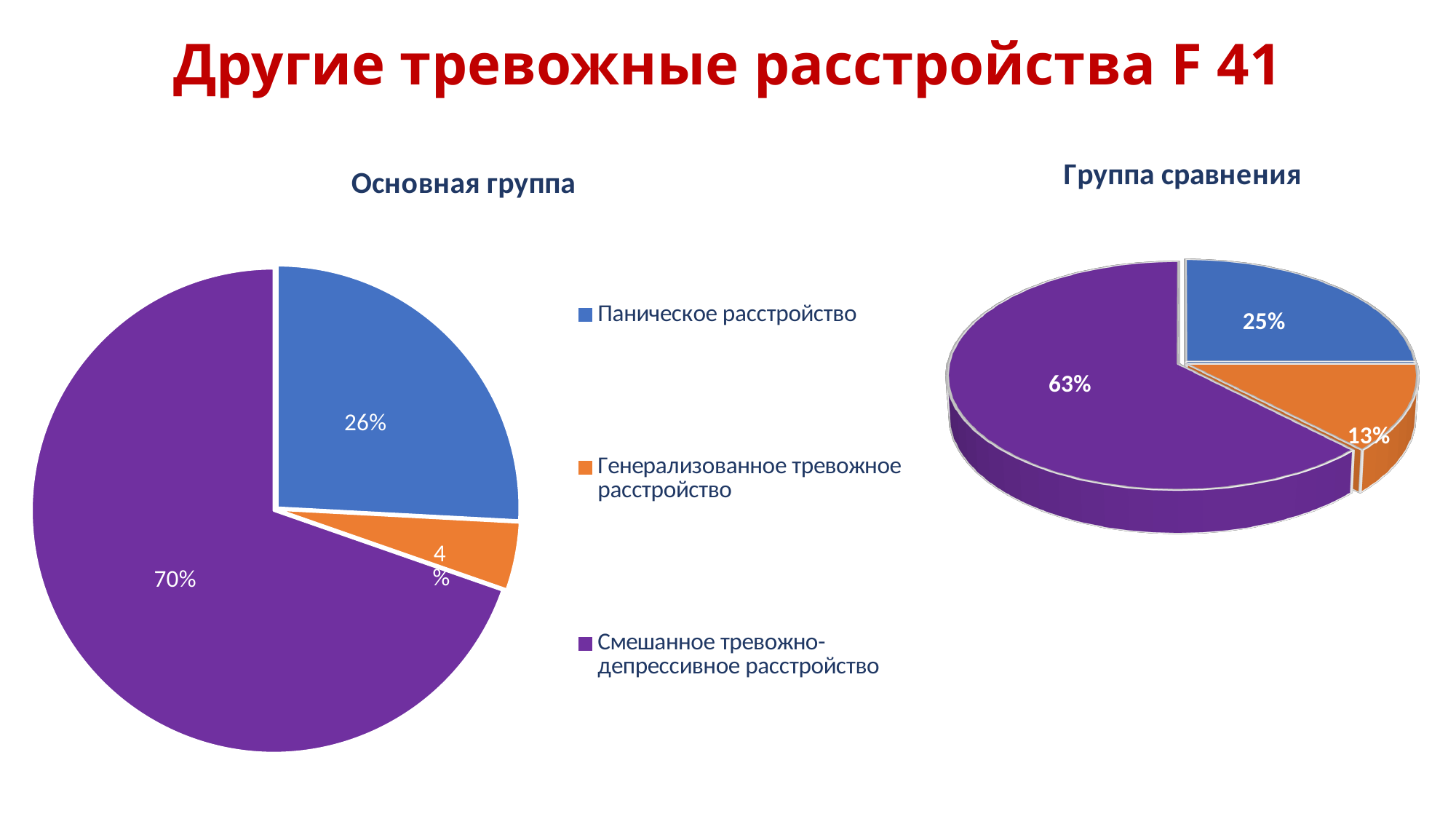
In the "Основная группа" chart, which category has the smallest slice? Генерализованное тревожное расстройство In the "Группа сравнения" chart, what share does "Паническое расстройство" have? 25% What kind of chart is the "Основная группа" chart? Pie chart What colour represents "Паническое расстройство" in the legend? Blue In the "Основная группа" chart, what share does "Паническое расстройство" have? 26% In the "Группа сравнения" chart, what share does "Генерализованное тревожное расстройство" have? 13% In the "Группа сравнения" chart, which category has the largest slice? Смешанное тревожно-депрессивное расстройство How many slices does the "Группа сравнения" chart have? 3 In the "Основная группа" chart, what share does "Смешанное тревожно-депрессивное расстройство" have? 70% In the "Основная группа" chart, what share does "Генерализованное тревожное расстройство" have? 4% Which chart shows a larger share for "Генерализованное тревожное расстройство", "Основная группа" or "Группа сравнения"? Группа сравнения In the "Основная группа" chart, what is the difference between the shares of "Смешанное тревожно-депрессивное расстройство" and "Паническое расстройство"? 44%